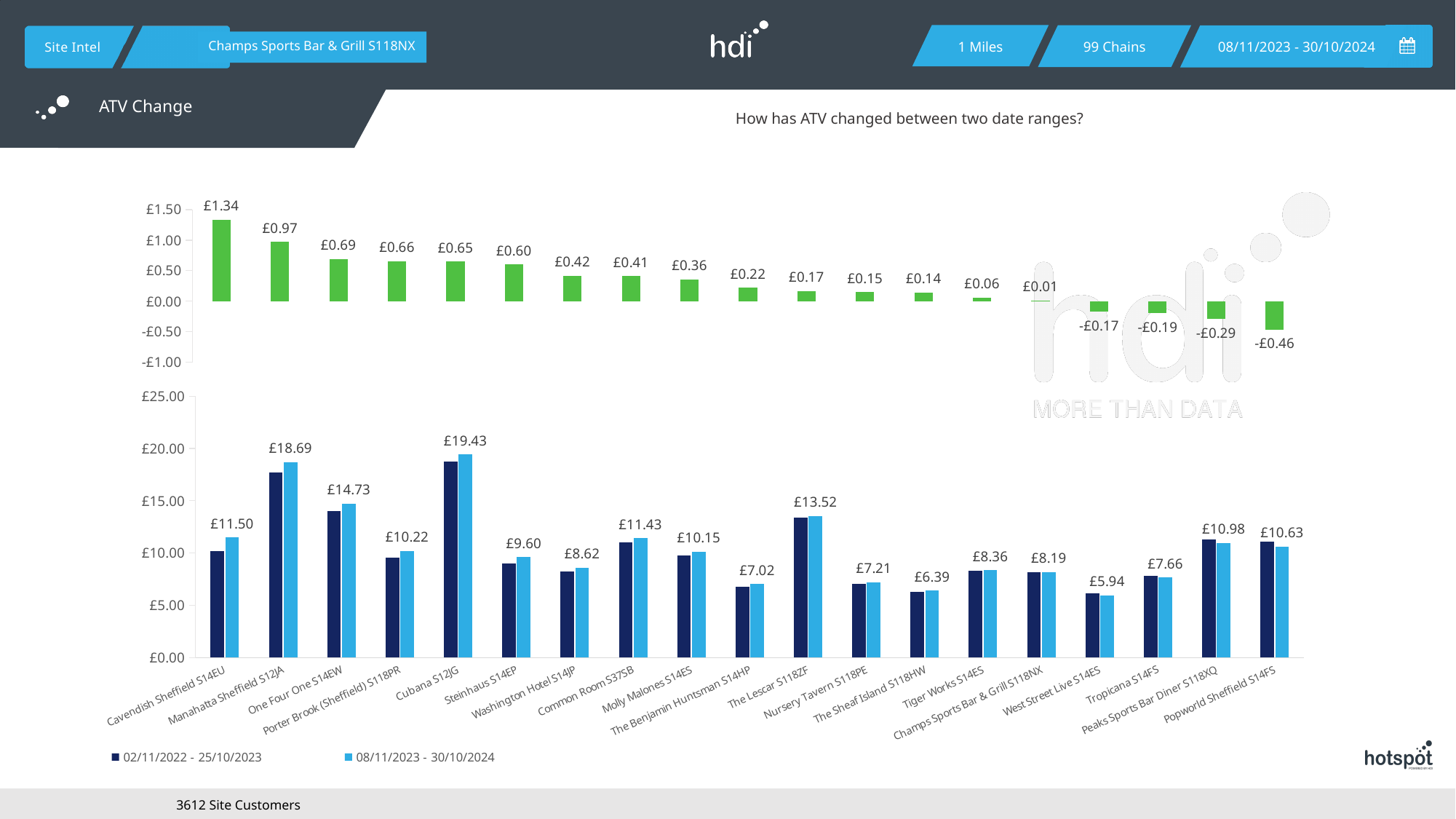
In the bottom chart, what value is labelled for Manahatta Sheffield S12JA? £18.69 What kind of chart is the bottom chart on the slide? bar chart In the top chart (ATV change), what is the lowest value shown? -£0.46 How many categories are shown on the x axis of the bottom chart? 19 In the bottom chart, what is the difference between the labelled values for Cubana S12JG and Manahatta Sheffield S12JA? £0.74 In the bottom chart, for Cavendish Sheffield S14EU, which period has the taller bar? 08/11/2023 - 30/10/2024 In the bottom chart, what value is labelled for Cubana S12JG? £19.43 How many series does the legend of the bottom chart list? 2 What are the two legend entries of the bottom chart? 02/11/2022 - 25/10/2023 and 08/11/2023 - 30/10/2024 In the top chart (ATV change), what is the highest value shown? £1.34 In the bottom chart, what value is labelled for West Street Live S14ES? £5.94 In the bottom chart, is the 02/11/2022 - 25/10/2023 bar for The Lescar S118ZF greater or less than £10.00? greater